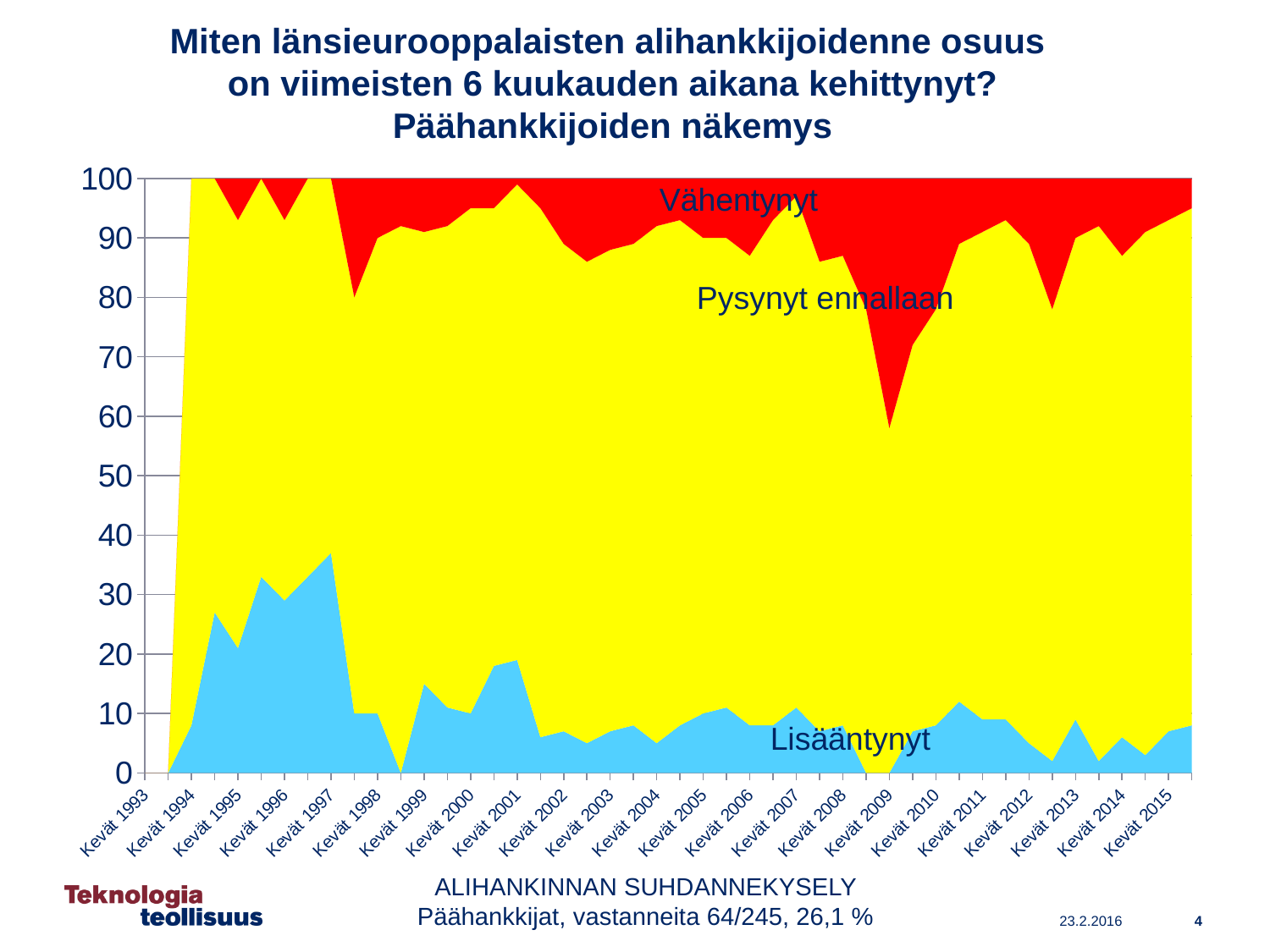
How many series are labelled in the chart? 3 Does the Lisääntynyt series rise or fall between Kevät 1997 and Kevät 1998? fall What is the highest value shown on the y axis? 100 Which series is shown in red? Vähentynyt Is the value for Vähentynyt at Kevät 2009 greater or less than 30? greater What kind of chart is shown on the slide? Stacked area chart Is the value for Lisääntynyt at Kevät 1997 greater or less than 30? greater Which series occupies the largest share of the chart across the years? Pysynyt ennallaan How many 'Kevät' year labels are shown on the x axis? 23 Is the value for Lisääntynyt at Kevät 2001 greater or less than 10? greater Which series is shown in blue at the bottom of the chart? Lisääntynyt